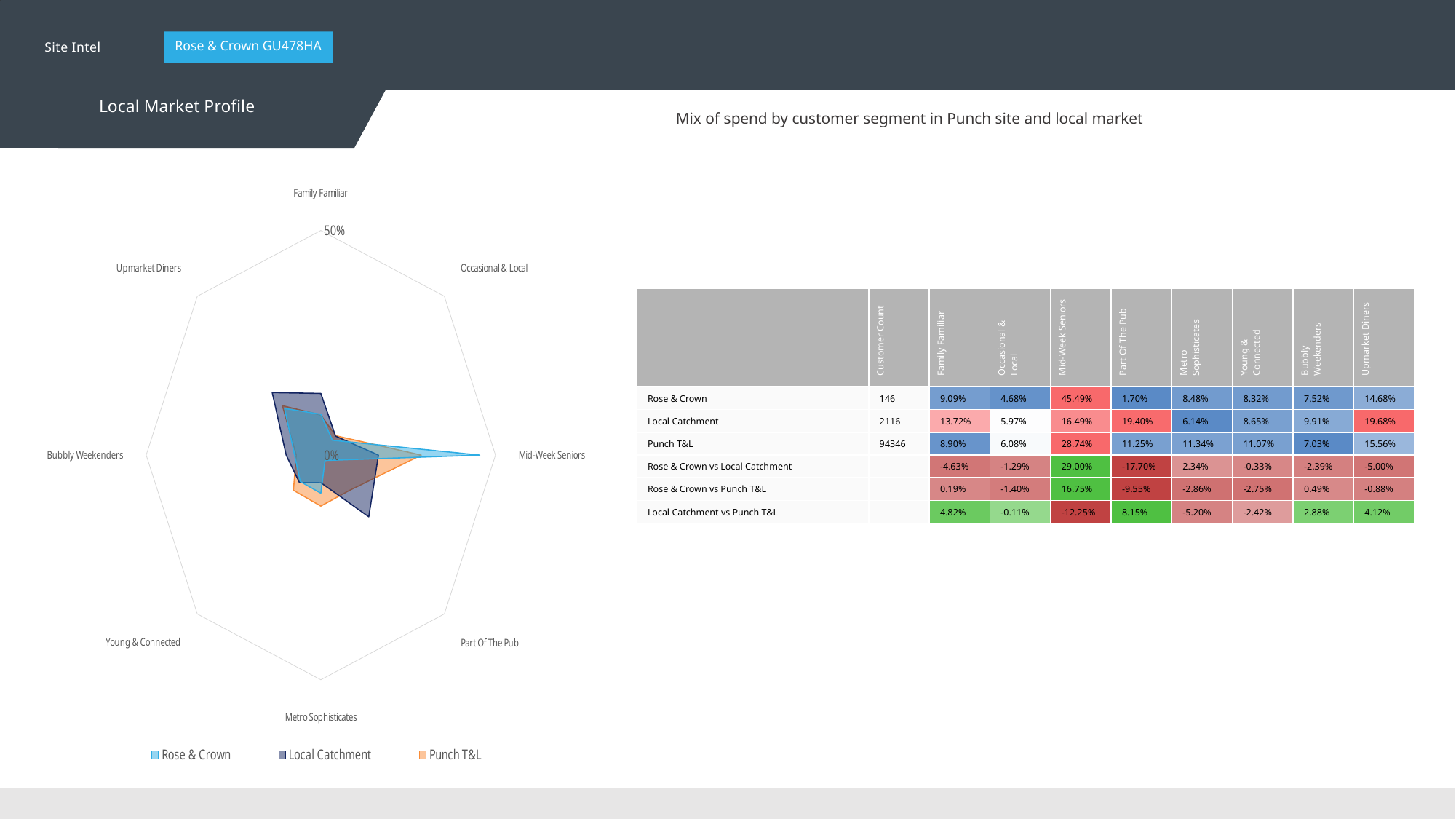
Which customer segment has the highest value for Rose & Crown? Mid-Week Seniors How many customer segment categories are plotted on the radar chart? 8 Which customer segment has the highest value for Local Catchment? Upmarket Diners Is the Rose & Crown value for Mid-Week Seniors greater or less than 50%? less What is the Local Catchment value for Part Of The Pub? 19.40% For Mid-Week Seniors, which is larger: Rose & Crown or Punch T&L? Rose & Crown Which customer segment has the highest value for Punch T&L? Mid-Week Seniors What kind of chart is shown on the left of the slide? Radar chart How many series does the radar chart's legend list? 3 What is the Rose & Crown value for Mid-Week Seniors? 45.49% Which customer segment has the lowest value for Rose & Crown? Part Of The Pub What is the difference between Rose & Crown and Local Catchment for Mid-Week Seniors? 29.00%